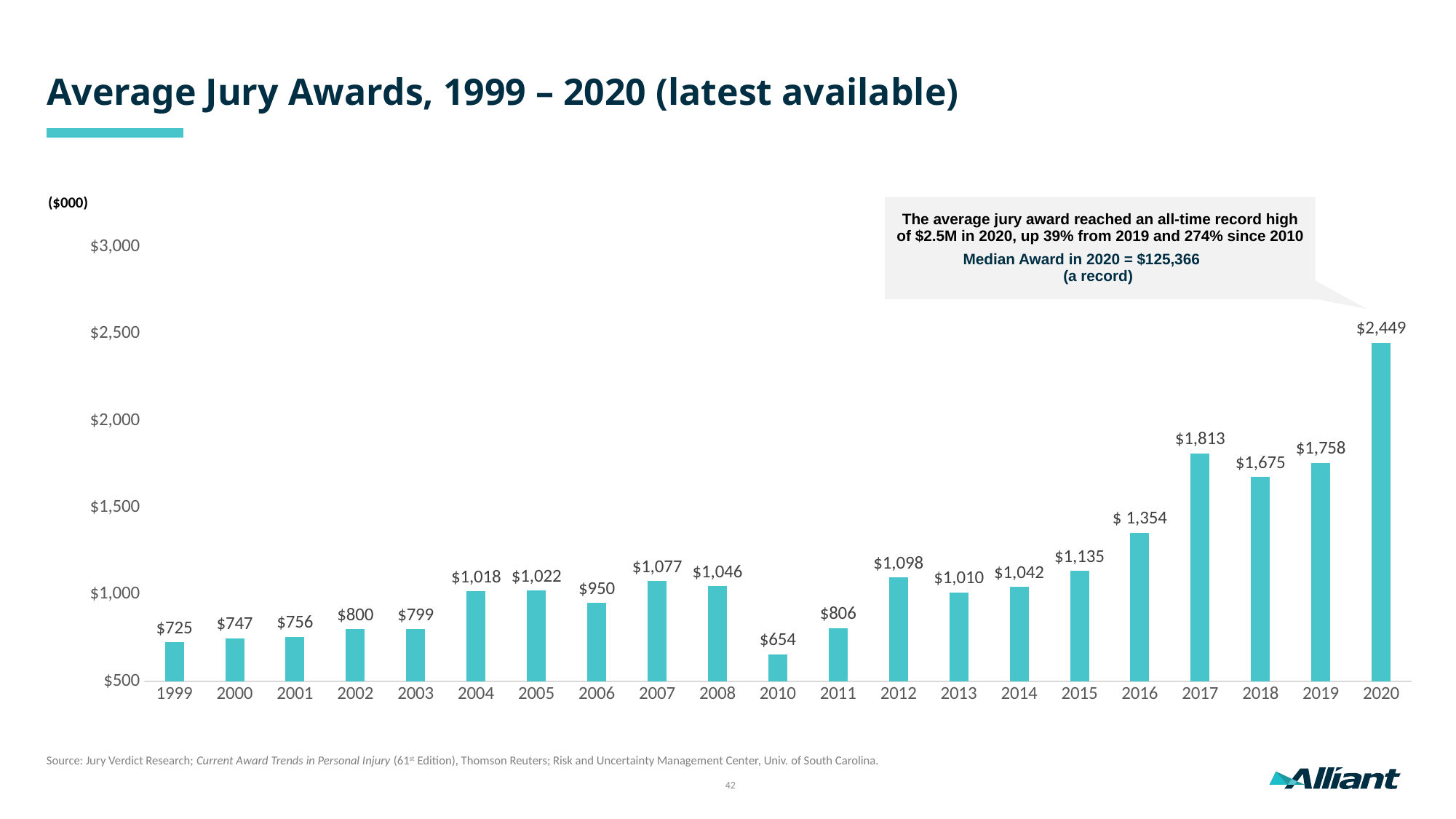
What is the average jury award shown for 2007? $1,077 Which year has the lowest average jury award? 2010 Which year has the highest average jury award? 2020 How many years are plotted on the chart? 21 What unit is indicated for the values on the chart's vertical axis? ($000) Which year has the larger average jury award, 2017 or 2018? 2017 What kind of chart is shown on the slide? Bar chart What is the average jury award shown for 2020? $2,449 What is the average jury award shown for 2010? $654 What is the difference between the average jury award in 2017 and in 2016? $459 Do the average jury awards generally rise or fall from 1999 to 2020? Rise What is the difference between the average jury award in 2020 and in 2019? $691